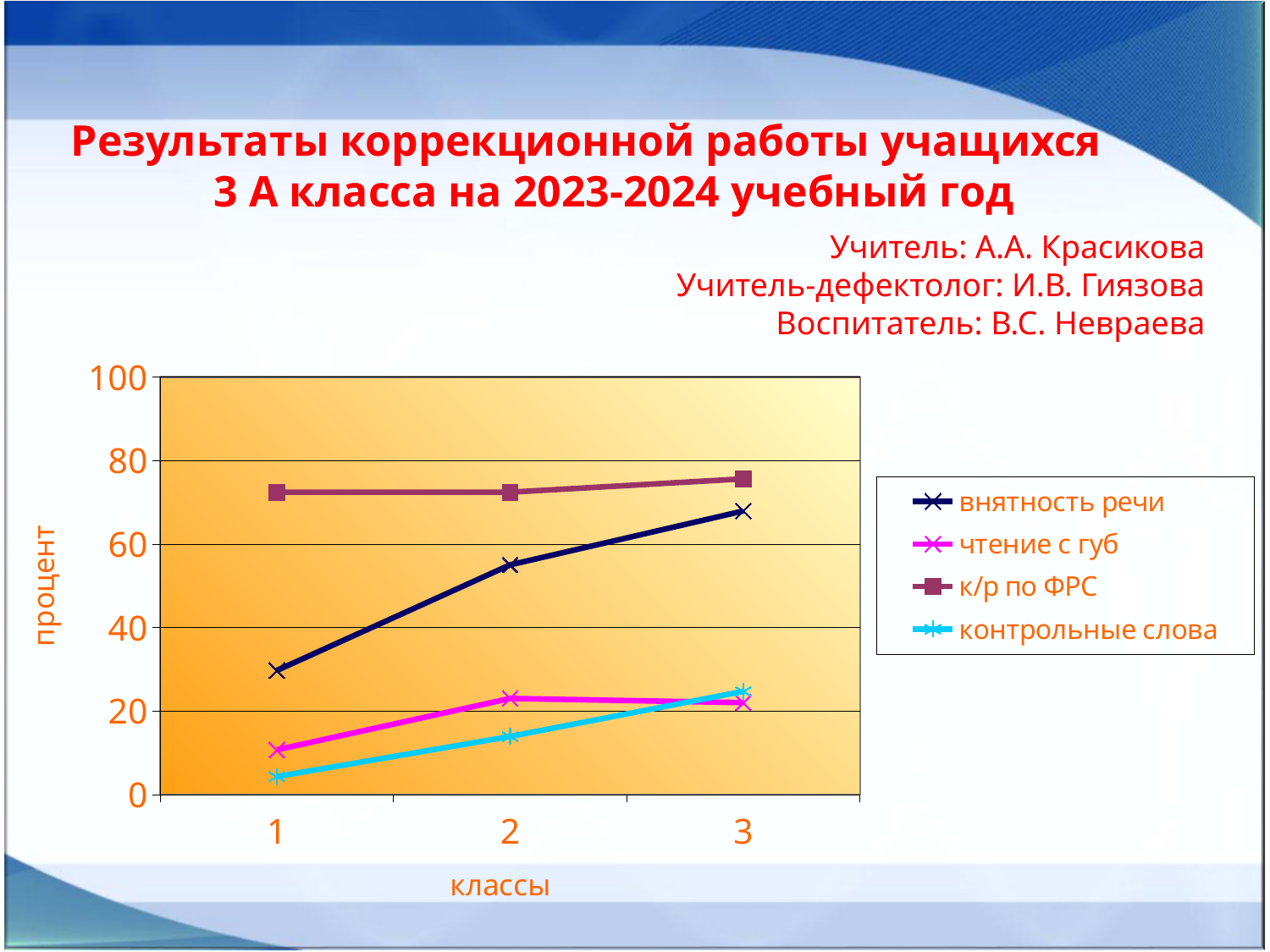
How many series does the legend list? 4 Does the value for контрольные слова rise or fall from class 1 to class 3? rise Which series has the lowest value at class 1? контрольные слова Which series has the highest value at class 1? к/р по ФРС Is the value for внятность речи at class 3 greater or less than 60? greater At class 2, which is larger: внятность речи or чтение с губ? внятность речи Is the value for внятность речи at class 1 greater or less than 40? less What kind of chart is shown on the slide? line chart Is the value for контрольные слова at class 1 greater or less than 20? less Does the value for внятность речи rise or fall from class 1 to class 3? rise How many points are plotted along the x axis for each series? 3